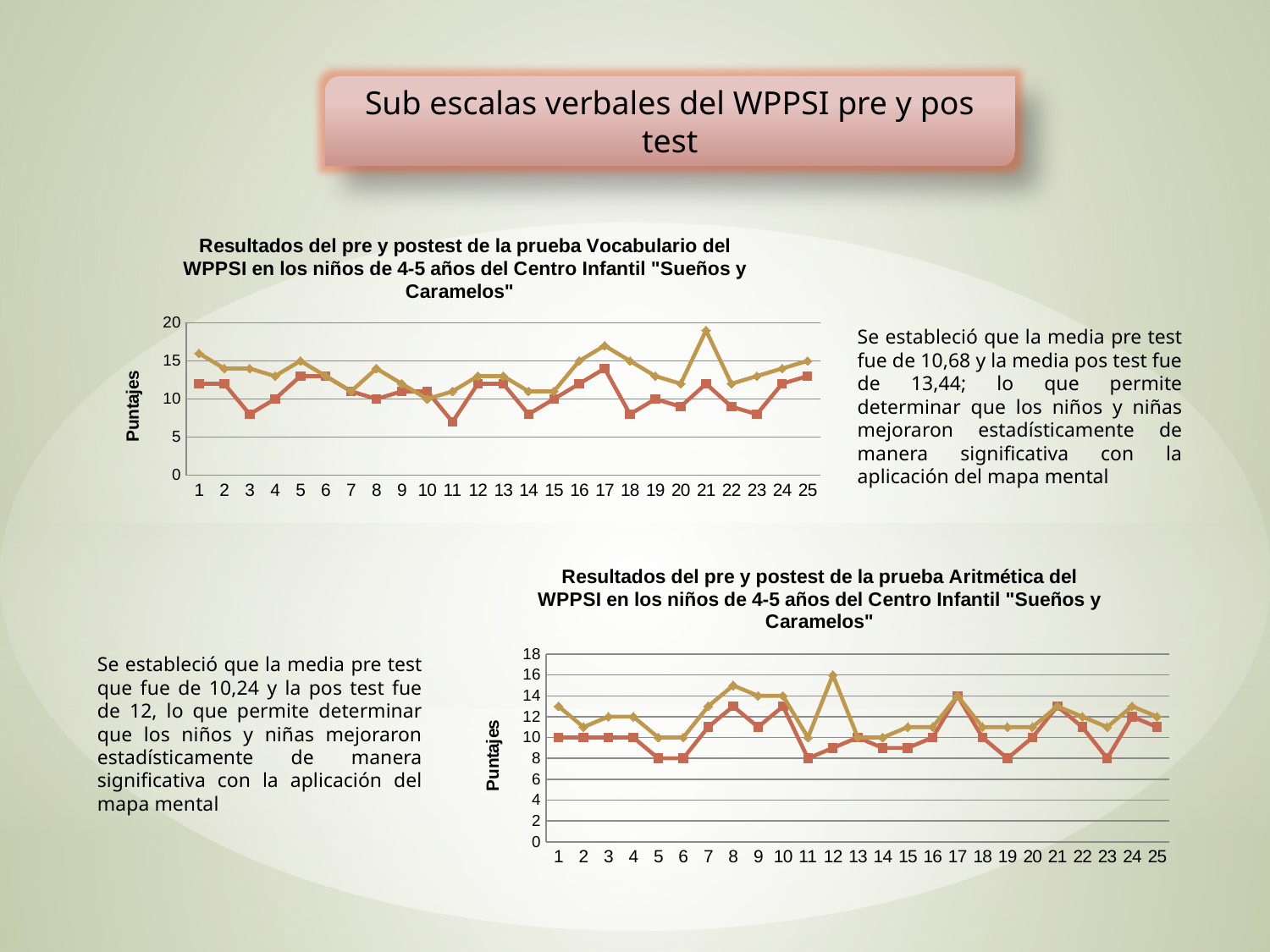
How many points are plotted along the x axis of the Vocabulario chart? 25 What is the highest tick value shown on the y axis of the Aritmética chart? 18 What kind of chart is the 'Resultados del pre y postest de la prueba Vocabulario' chart? line chart How many points are plotted along the x axis of the 'Resultados del pre y postest de la prueba Aritmética' chart? 25 In the Vocabulario chart, at which x-axis point does the gold line reach its highest value? 21 In the Vocabulario chart, is the value of the gold line at point 21 greater or less than 15? greater In the Aritmética chart, is the value of the red line at point 5 greater or less than 10? less In the Aritmética chart, at which x-axis point does the gold line reach its highest value? 12 What is the label on the y axis of the Vocabulario chart? Puntajes In the Vocabulario chart, is the value of the red line at point 11 greater or less than 10? less In the Aritmética chart, which line has the larger value at point 12, the gold line or the red line? the gold line